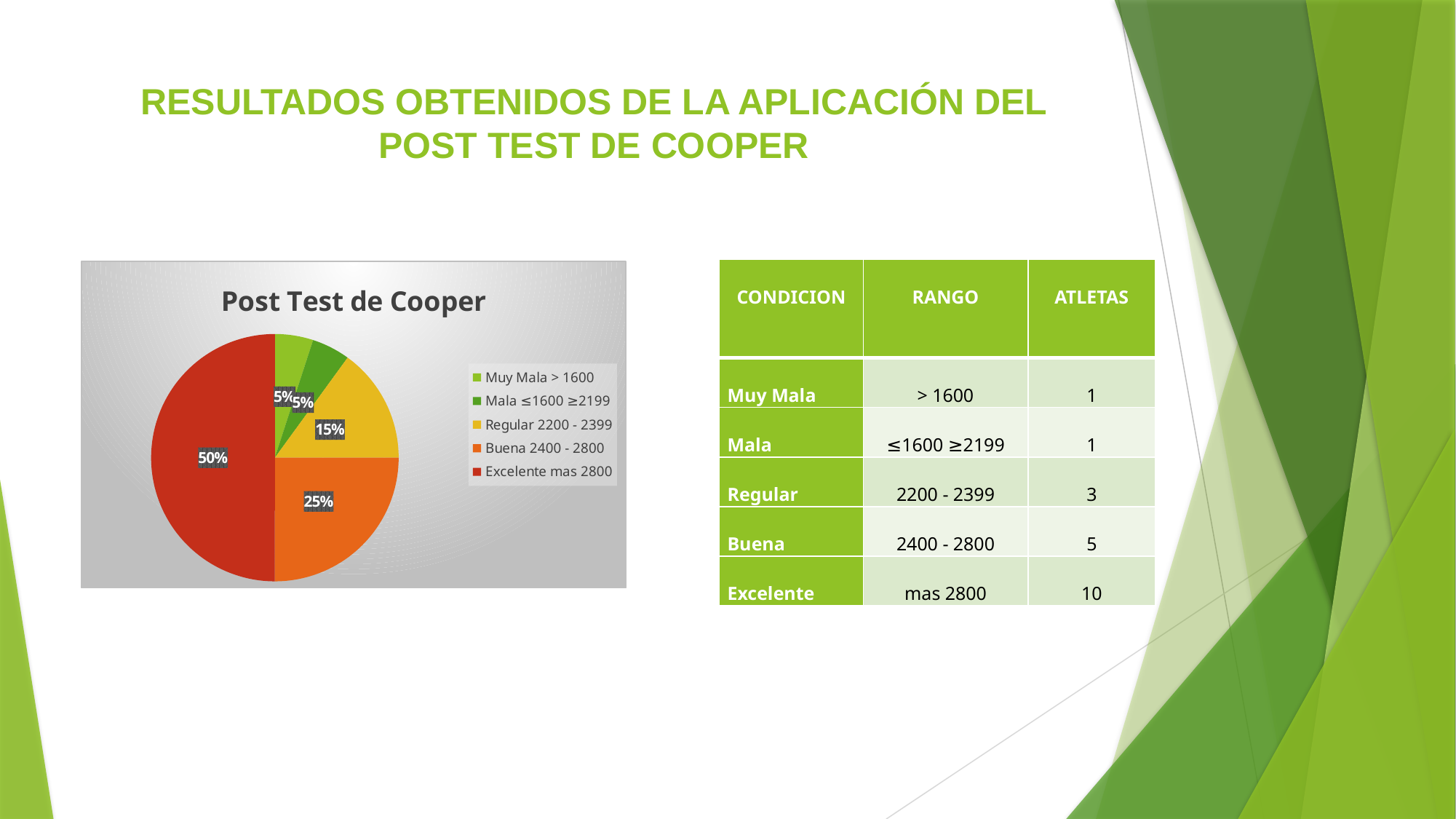
What colour is the Excelente mas 2800 slice? red What share of the pie does the Excelente mas 2800 slice represent? 50% Which category has the largest slice of the pie? Excelente mas 2800 What kind of chart is shown on the slide? pie chart What share of the pie does the Regular 2200 - 2399 slice represent? 15% What share of the pie does the Muy Mala > 1600 slice represent? 5% What is the title of the chart? Post Test de Cooper How many slices does the pie chart have? 5 Which is larger, the Regular 2200 - 2399 slice or the Mala ≤1600 ≥2199 slice? Regular 2200 - 2399 How many entries does the legend list? 5 What is the difference between the Excelente mas 2800 share and the Buena 2400 - 2800 share? 25%